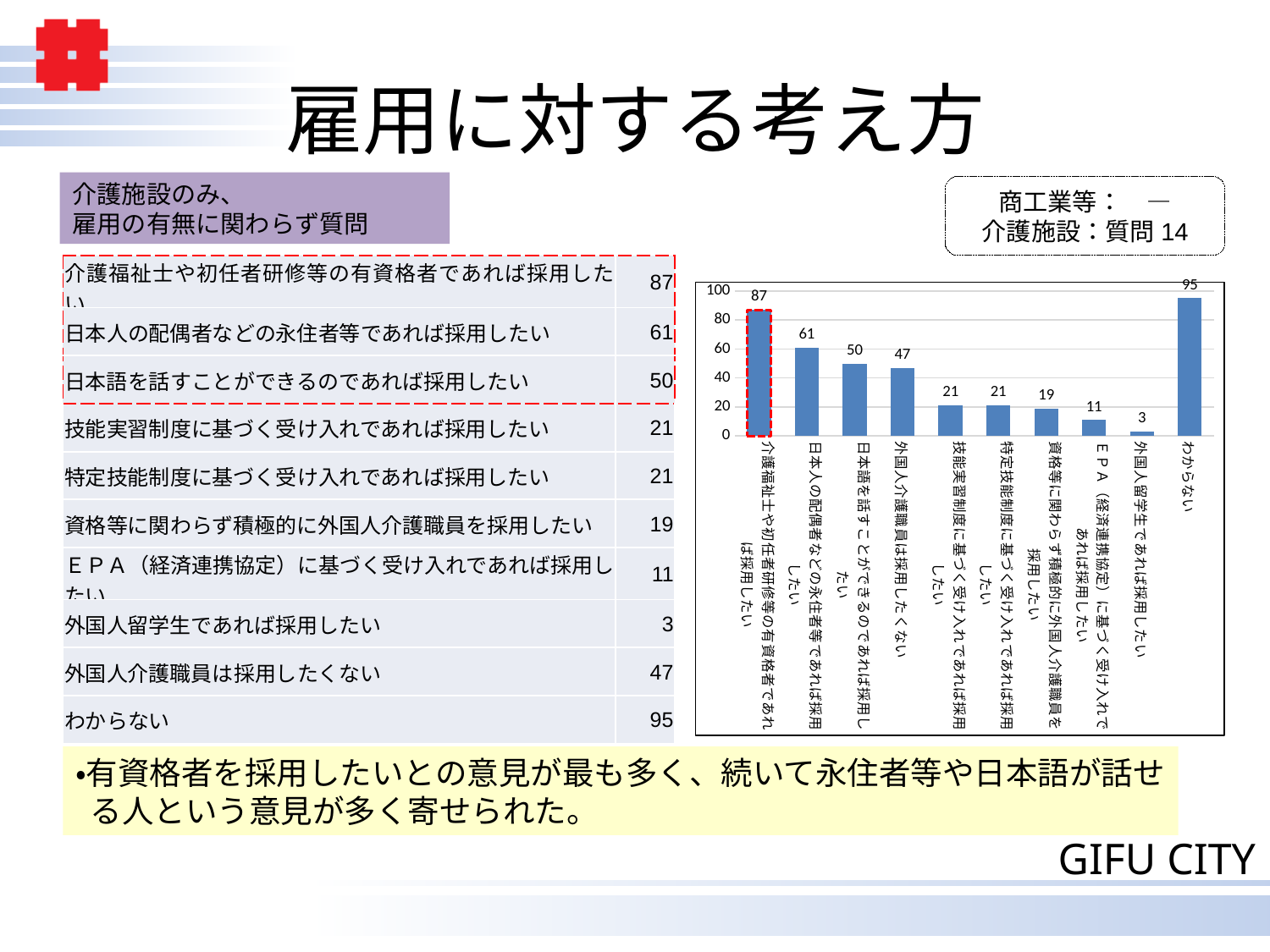
What is the difference between the values for 「日本語を話すことができるのであれば採用したい」 and 「外国人介護職員は採用したくない」? 3 What is the value for 「外国人介護職員は採用したくない」 in the chart? 47 What is the value for 「わからない」 in the chart? 95 Which is larger: the value for 「日本人の配偶者などの永住者等であれば採用したい」 or for 「日本語を話すことができるのであれば採用したい」? 日本人の配偶者などの永住者等であれば採用したい What type of chart is shown on the slide? bar chart Which category has the lowest value in the chart? 外国人留学生であれば採用したい What is the value for 「介護福祉士や初任者研修等の有資格者であれば採用したい」 in the chart? 87 What is the value for 「ＥＰＡ（経済連携協定）に基づく受け入れであれば採用したい」 in the chart? 11 How many categories (bars) does the chart show? 10 Which category has the highest value in the chart? わからない What is the difference between the values for 「わからない」 and 「介護福祉士や初任者研修等の有資格者であれば採用したい」? 8 What is the maximum value shown on the chart's vertical axis? 100